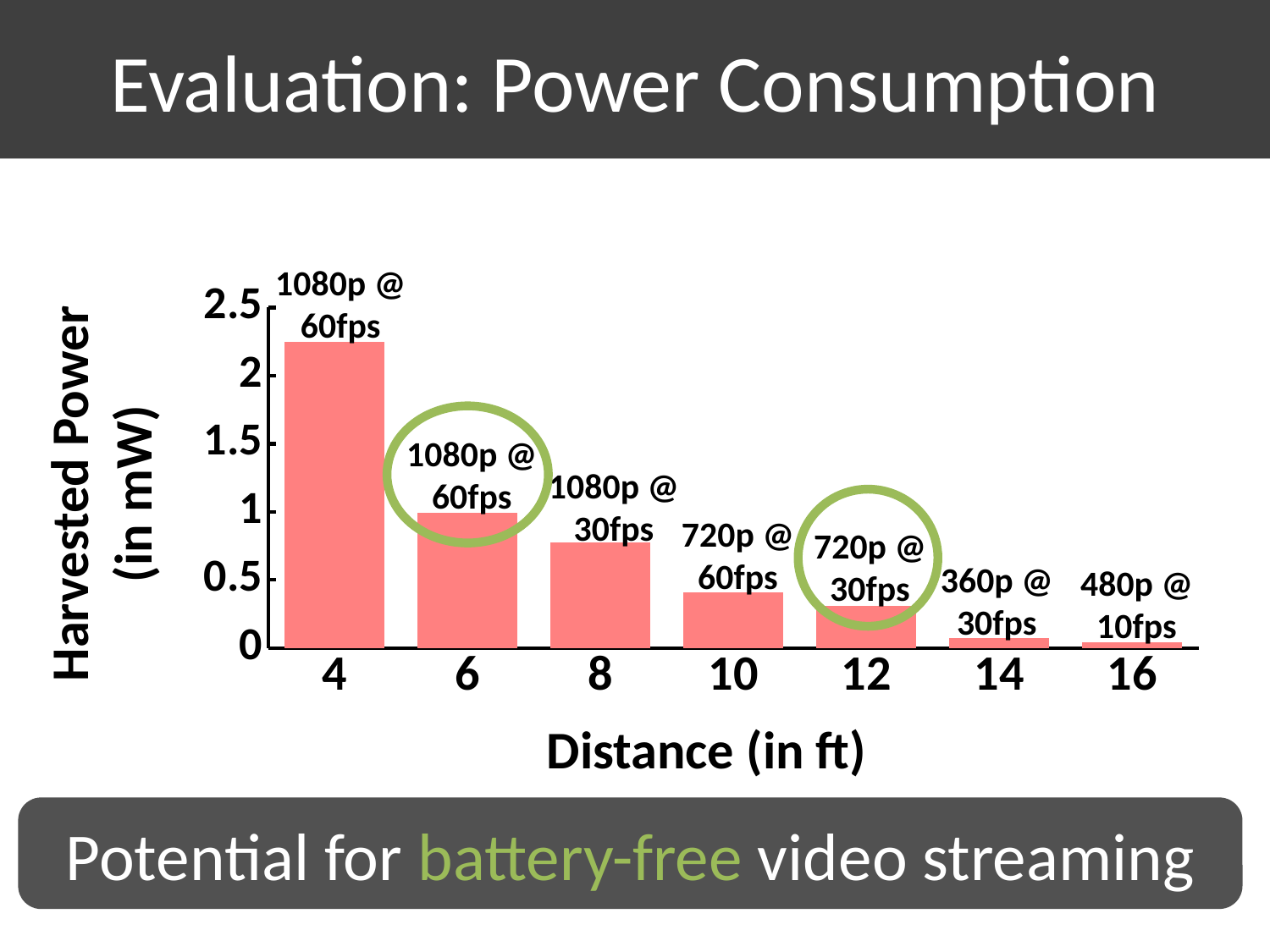
Is the harvested power at 6 ft greater or less than 0.5 mW? greater What is the label of the y axis? Harvested Power (in mW) Which has the larger harvested power, 8 ft or 10 ft? 8 ft At which distance is the harvested power highest? 4 Is the harvested power at 10 ft greater or less than 0.5 mW? less Is the harvested power at 4 ft greater or less than 2 mW? greater What kind of chart is shown on the slide? bar chart What video quality label is shown above the bar at 4 ft? 1080p @ 60fps Does the harvested power rise or fall as distance increases along the x axis? fall How many distance categories are plotted on the x axis? 7